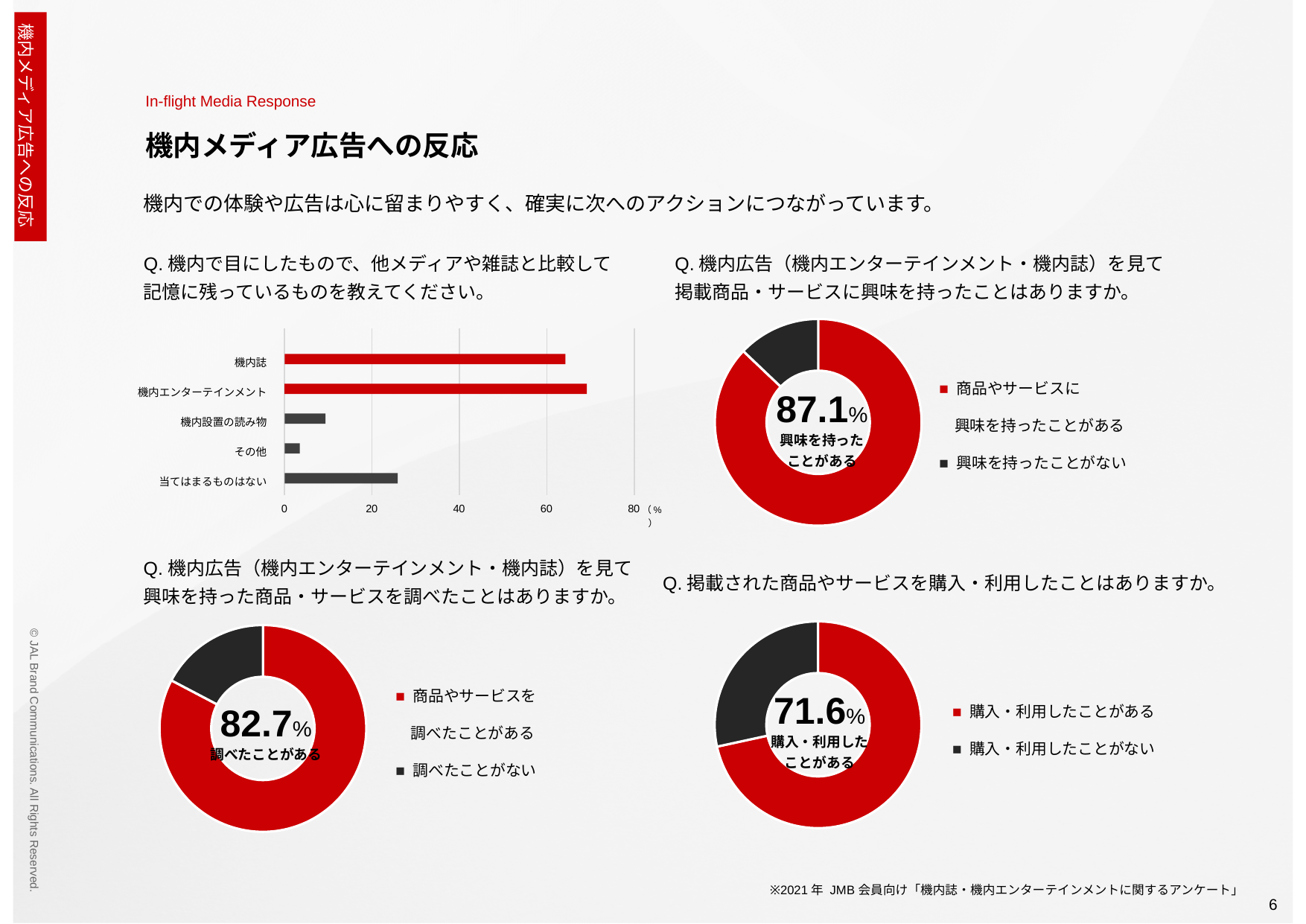
In the bar chart at the top left, which category has the shortest bar? その他 In the bar chart at the top left, is the value for 機内誌 greater or less than 60? greater In the bar chart at the top left, which category has the longest bar? 機内エンターテインメント How many categories are shown in the bar chart at the top left? 5 In the bar chart at the top left, is the value for 当てはまるものはない greater or less than 20? greater In the donut chart at the bottom right, what percentage of respondents answered 購入・利用したことがある? 71.6% What kind of chart is the chart at the top left of the slide? bar chart In the donut chart at the top right, what percentage of respondents answered 商品やサービスに興味を持ったことがある? 87.1% How many entries does the legend of the donut chart at the bottom right list? 2 In the donut chart at the bottom left, what percentage of respondents answered 商品やサービスを調べたことがある? 82.7% In the bar chart at the top left, is the value for 機内設置の読み物 greater or less than 20? less In the bar chart at the top left, which is larger, the value for 機内誌 or the value for 当てはまるものはない? 機内誌